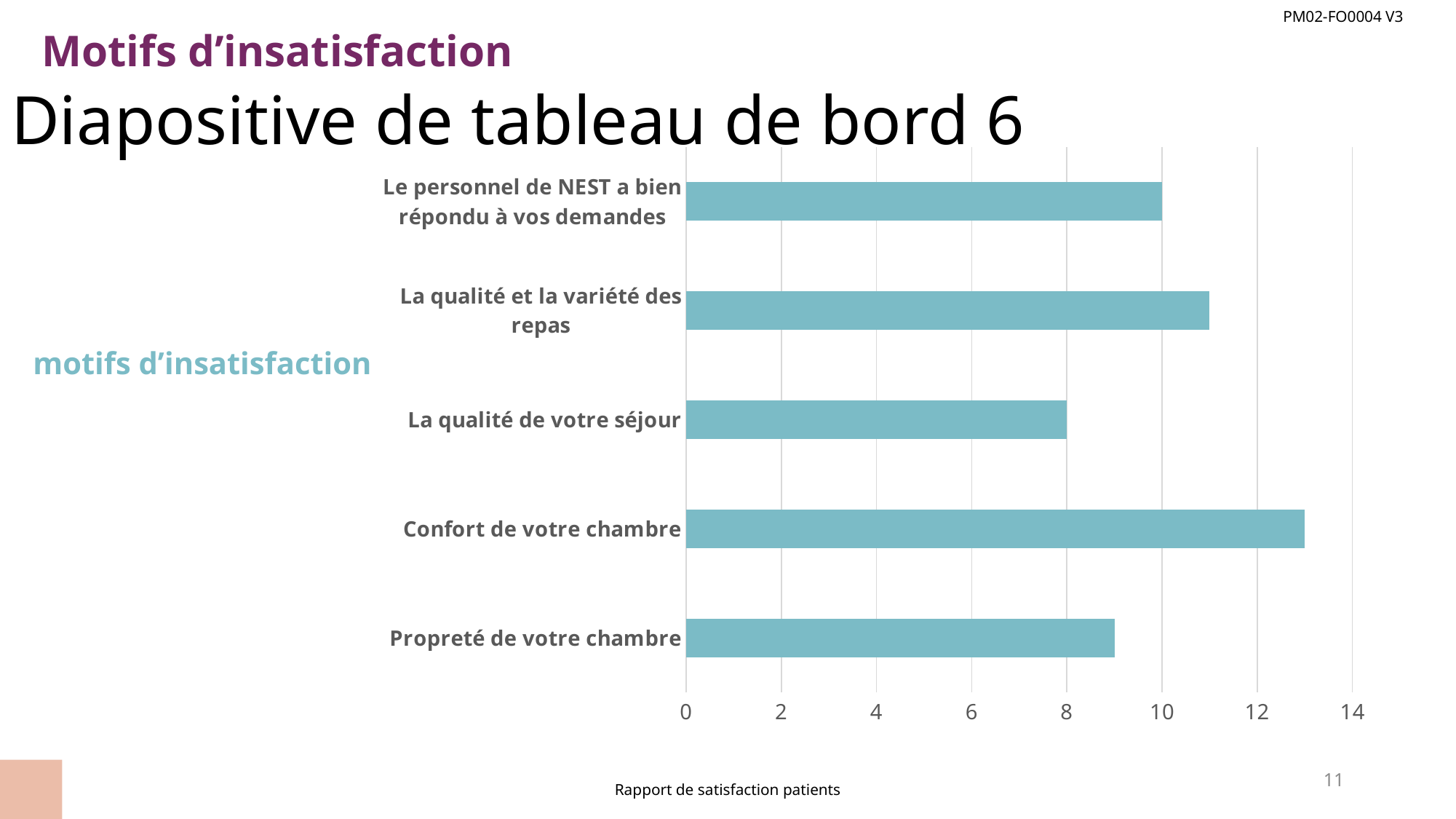
Is the value for "Confort de votre chambre" greater or less than 12? greater Is the value for "La qualité et la variété des repas" greater or less than 10? greater Which is larger, the value for "Confort de votre chambre" or the value for "La qualité et la variété des repas"? Confort de votre chambre What is the difference between the values for "Le personnel de NEST a bien répondu à vos demandes" and "La qualité de votre séjour"? 2 What is the highest value shown on the horizontal axis of the chart? 14 How many categories are plotted in the chart? 5 Which category has the highest value? Confort de votre chambre Is the value for "Propreté de votre chambre" greater or less than 10? less Which category has the lowest value? La qualité de votre séjour What kind of chart is shown on the slide? bar chart What is the value for "La qualité de votre séjour"? 8 What is the value for "Le personnel de NEST a bien répondu à vos demandes"? 10